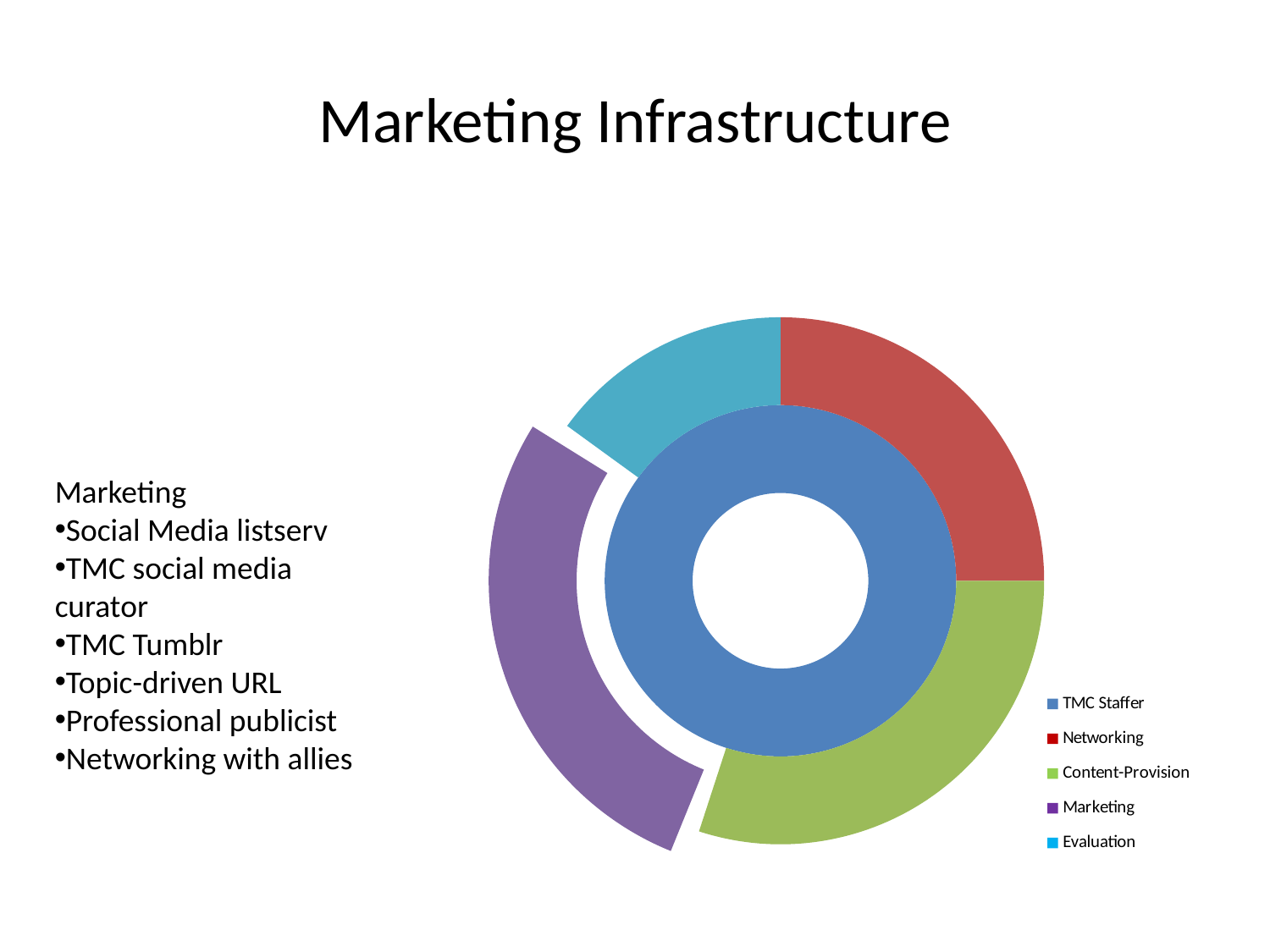
How many entries does the chart legend list? 5 Which category occupies the entire inner ring of the doughnut chart? TMC Staffer What colour represents Content-Provision in the chart? green Which is larger in the outer ring, Marketing or Evaluation? Marketing Which is larger in the outer ring, Networking or Evaluation? Networking Which slice of the outer ring is the smallest? Evaluation What kind of chart is shown on the slide? doughnut chart Which slice of the outer ring is pulled out (exploded) from the rest of the ring? Marketing How many slices make up the outer ring of the doughnut chart? 4